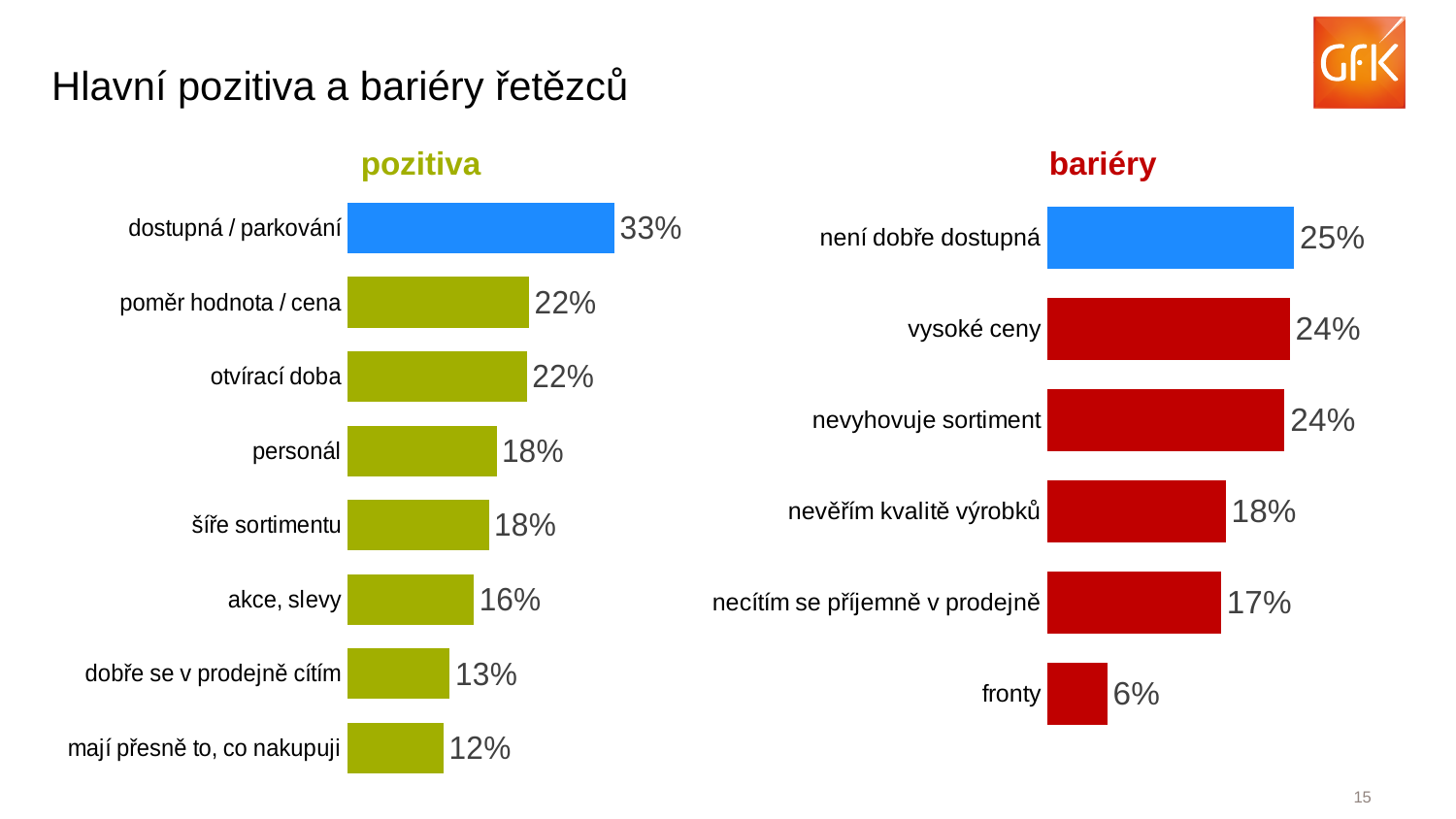
What type of chart is the 'bariéry' chart? bar chart In the 'pozitiva' chart, which is larger: 'personál' or 'akce, slevy'? personál In the 'bariéry' chart, what is the value for 'fronty'? 6% In the 'pozitiva' chart, what is the difference between 'dostupná / parkování' and 'mají přesně to, co nakupuji'? 21% How many categories are shown in the 'bariéry' chart? 6 In the 'pozitiva' chart, what is the value for 'dostupná / parkování'? 33% How many categories are shown in the 'pozitiva' chart? 8 In the 'bariéry' chart, what is the difference between 'není dobře dostupná' and 'nevěřím kvalitě výrobků'? 7% In the 'bariéry' chart, which category has the lowest value? fronty In the 'pozitiva' chart, which category has the highest value? dostupná / parkování In the 'bariéry' chart, what is the value for 'vysoké ceny'? 24% In the 'pozitiva' chart, what colour is the bar for 'dostupná / parkování'? blue